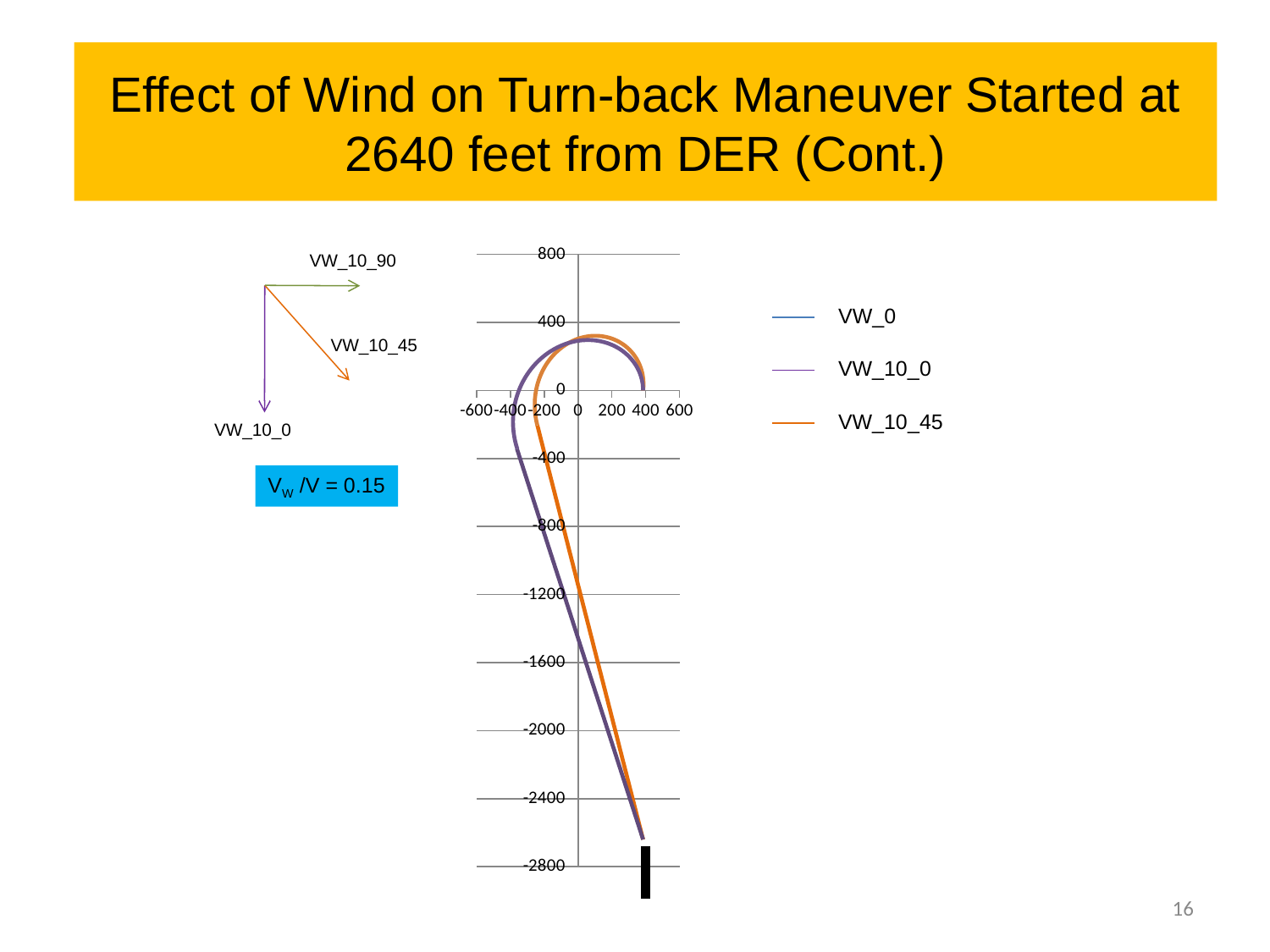
What colour is the VW_10_45 series drawn in? orange Is the y value at the bottom end of the trajectories greater or less than -2400? less Is the leftmost x value reached by the VW_10_45 curve greater or less than -400? greater What are the three series names listed in the legend? VW_0, VW_10_0, VW_10_45 Which curve extends further to the left on the x axis, VW_10_0 or VW_10_45? VW_10_0 Is the highest y value reached by the curves greater or less than 0? greater What kind of chart is shown on the slide? line chart How many series does the legend list? 3